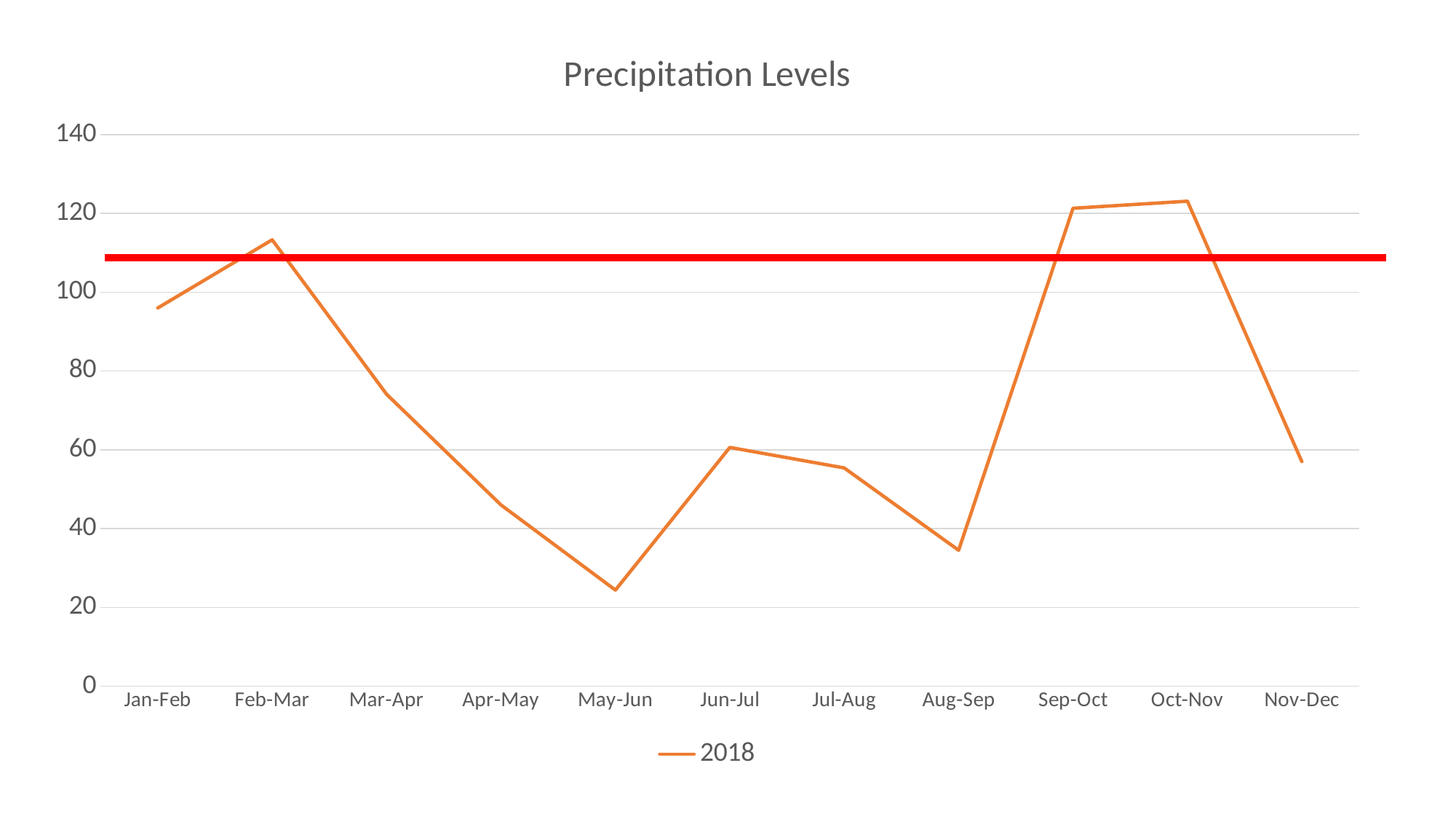
What is the title of the chart? Precipitation Levels How many series does the legend list? 1 Do the values rise or fall from Feb-Mar to May-Jun? fall Is the value for Jan-Feb greater or less than 100? less What series name appears in the legend? 2018 Which is larger, the value for Jan-Feb or the value for Nov-Dec? Jan-Feb Is the value for Aug-Sep greater or less than 40? less What kind of chart is shown on the slide? line chart Is the value for Feb-Mar greater or less than 100? greater How many categories are shown on the x axis? 11 Which category has the lowest precipitation level? May-Jun